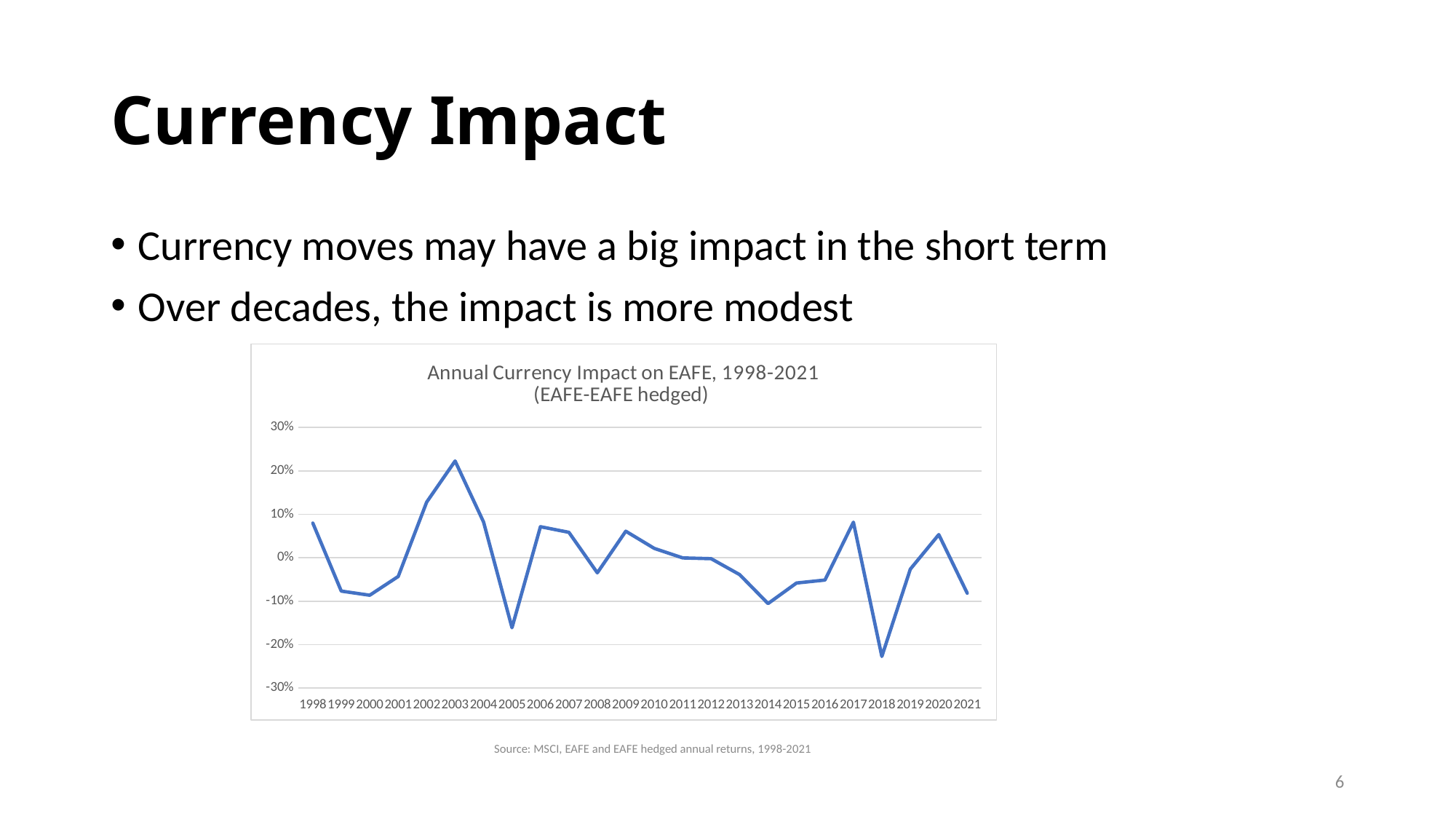
Is the value for 2018 greater or less than -10%? less Which year has the larger value, 2003 or 2005? 2003 Which year has the lowest value in the chart? 2018 Is the value for 2017 greater or less than 0%? greater How many years are plotted on the x axis of the chart? 24 Which year has the highest value in the chart? 2003 What kind of chart is shown on the slide? line chart Is the value for 2005 greater or less than -10%? less Does the value rise or fall from 2020 to 2021? fall Which year has the larger value, 2017 or 2018? 2017 What is the title of the chart? Annual Currency Impact on EAFE, 1998-2021 (EAFE-EAFE hedged)